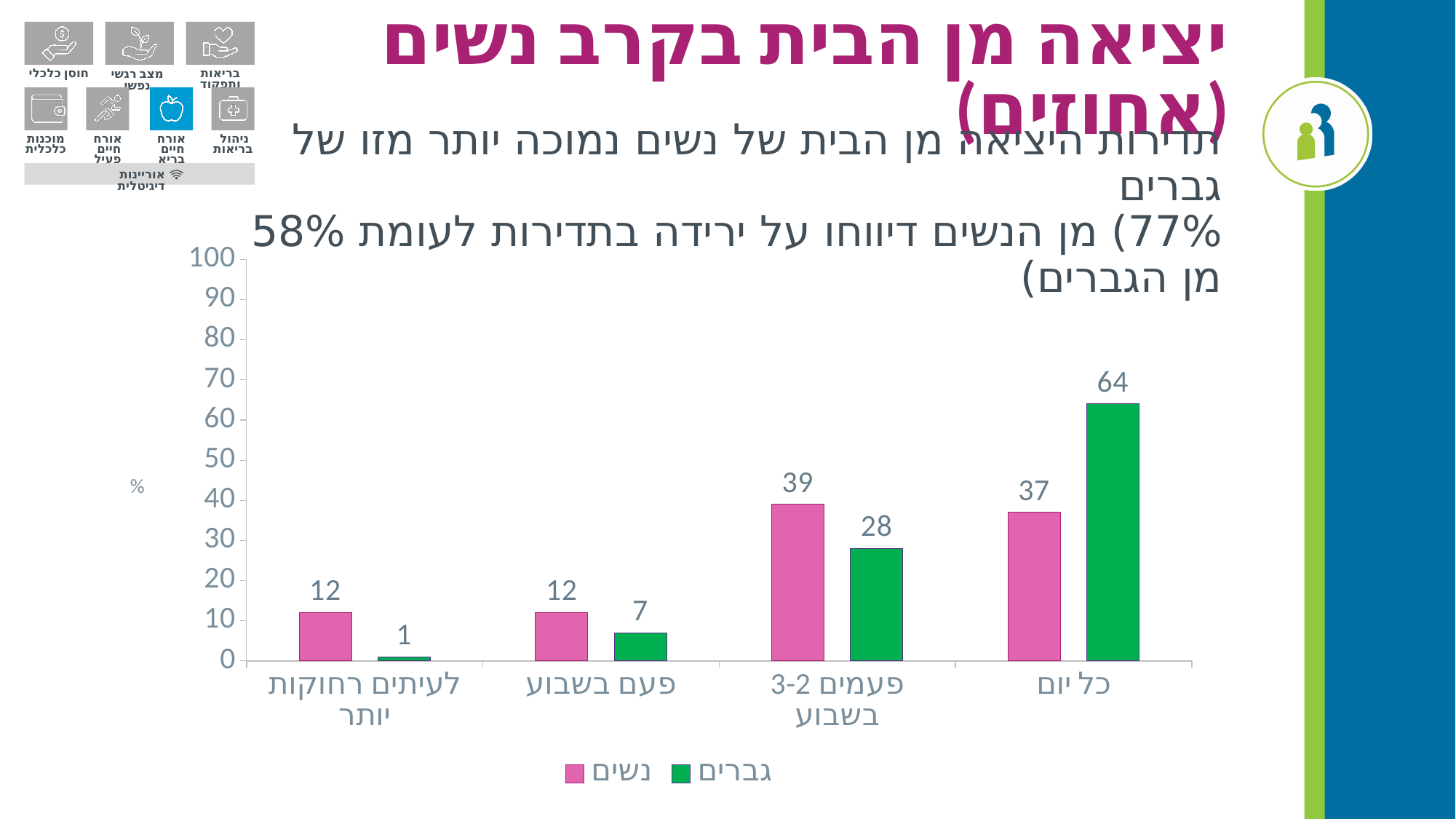
What is the value for גברים in the כל יום category? 64 What is the value for גברים in the לעיתים רחוקות יותר category? 1 How many series does the legend list? 2 What is the value for נשים in the 3-2 פעמים בשבוע category? 39 What kind of chart is shown on the slide? bar chart What is the value for נשים in the פעם בשבוע category? 12 In the 3-2 פעמים בשבוע category, which series is larger, נשים or גברים? נשים What is the difference between גברים and נשים in the כל יום category? 27 Which category has the lowest value for גברים? לעיתים רחוקות יותר How many categories are shown on the x axis? 4 Which category has the highest value for גברים? כל יום Which category has the highest value for נשים? 3-2 פעמים בשבוע